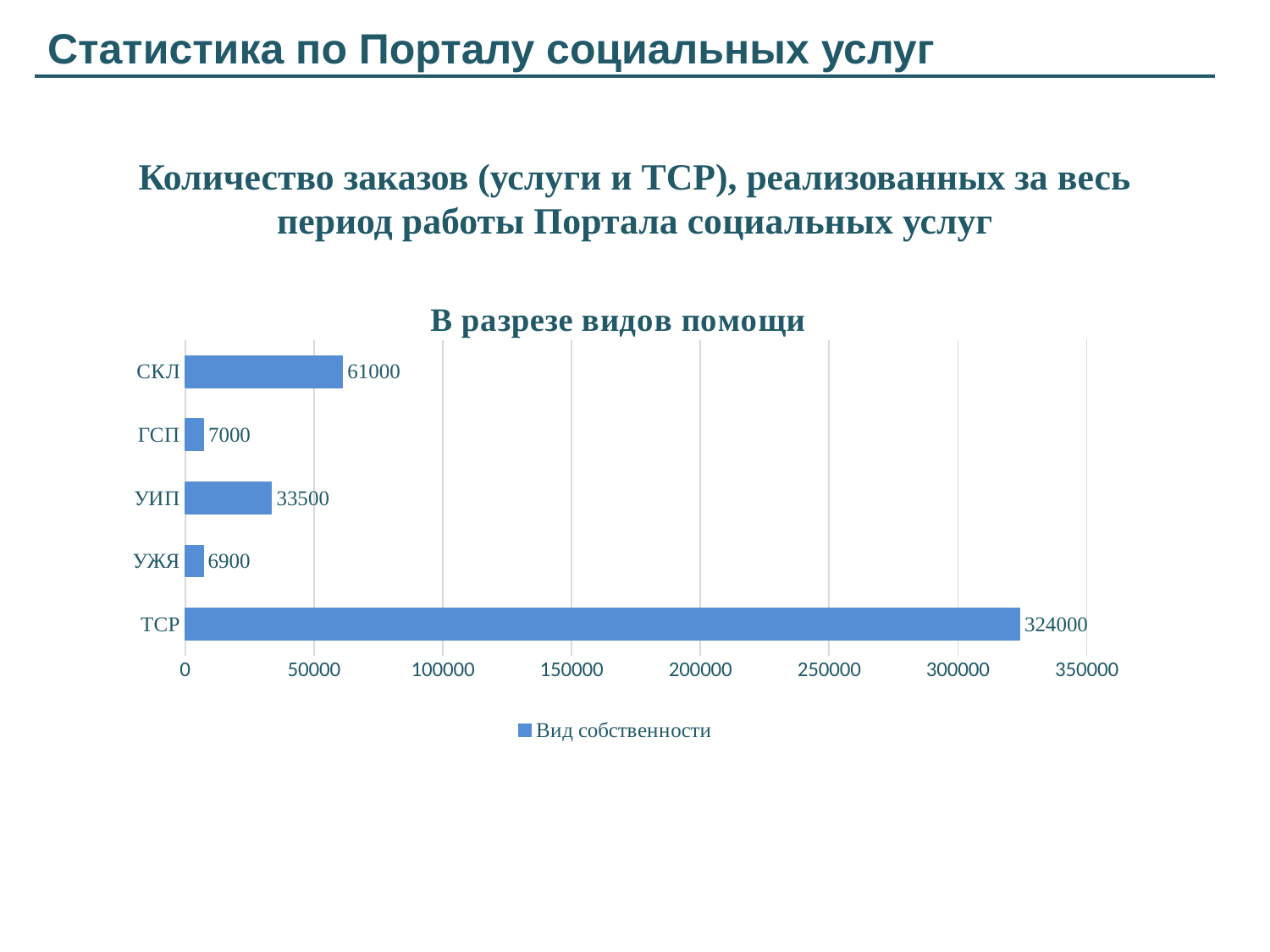
Which is larger, the value for УИП or the value for ГСП? УИП What is the legend entry shown below the chart? Вид собственности What is the value for ТСР? 324000 Which category has the highest value? ТСР How many categories are shown in the chart? 5 What is the value for СКЛ? 61000 What kind of chart is shown on the slide? bar chart Which category has the lowest value? УЖЯ What is the value for УИП? 33500 What is the difference between the values for ТСР and СКЛ? 263000 What is the difference between the values for СКЛ and УИП? 27500 What is the value for ГСП? 7000